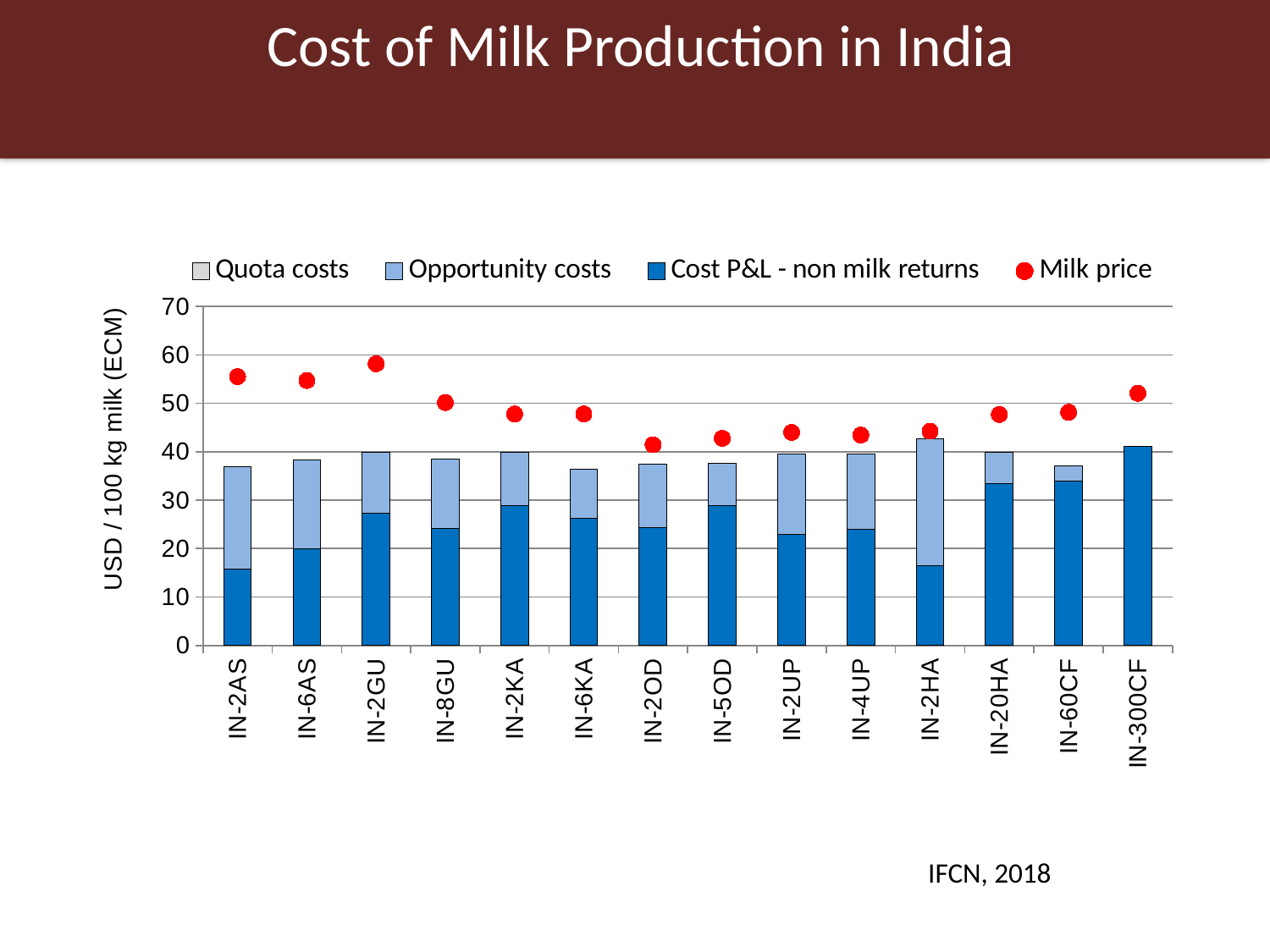
What is the label of the y axis? USD / 100 kg milk (ECM) Is the milk price for IN-2AS greater or less than 50? greater Which is larger, the milk price for IN-2GU or for IN-2OD? IN-2GU How many series does the legend list? 4 Is the Cost P&L - non milk returns value for IN-300CF greater or less than 30? greater What kind of chart is shown on the slide? bar chart Which category has the highest milk price? IN-2GU Is the milk price for IN-2OD greater or less than 50? less How many farm categories are shown on the x axis? 14 Which is larger, the Cost P&L - non milk returns value for IN-20HA or for IN-2AS? IN-20HA Which category has the highest Cost P&L - non milk returns value? IN-300CF